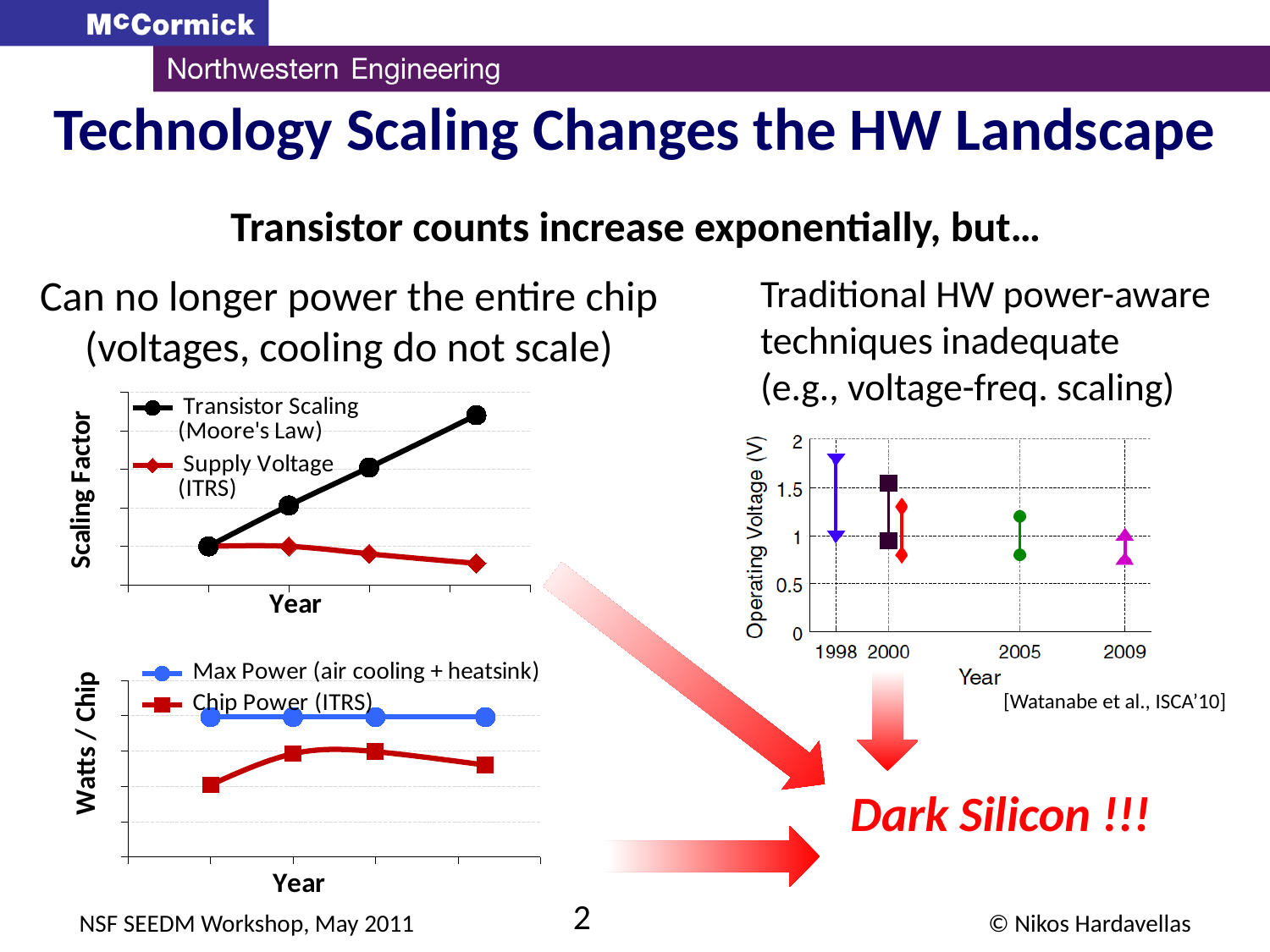
In the bottom-left Watts / Chip chart, which series is plotted higher: Max Power (air cooling + heatsink) or Chip Power (ITRS)? Max Power (air cooling + heatsink) In the top-left Scaling Factor chart, does the Supply Voltage (ITRS) series rise or fall along the Year axis? fall In the right-hand Operating Voltage (V) chart, is the upper end of the 2009 range greater or less than 1.5? less How many series does the legend of the bottom-left Watts / Chip chart list? 2 In the bottom-left Watts / Chip chart, does the Max Power (air cooling + heatsink) series rise, fall, or stay flat along the Year axis? stay flat What is the label of the x axis of the bottom-left Watts / Chip chart? Year How many data points are plotted for the Transistor Scaling (Moore's Law) series in the top-left chart? 4 How many series does the legend of the top-left Scaling Factor chart list? 2 In the top-left Scaling Factor chart, does the Transistor Scaling (Moore's Law) series rise or fall along the Year axis? rise In the right-hand Operating Voltage (V) chart, is the upper end of the 1998 range greater or less than 1.5? greater What kind of chart is the top-left chart with the y axis labelled Scaling Factor? line chart In the right-hand Operating Voltage (V) chart, how many year labels are shown on the x axis? 4